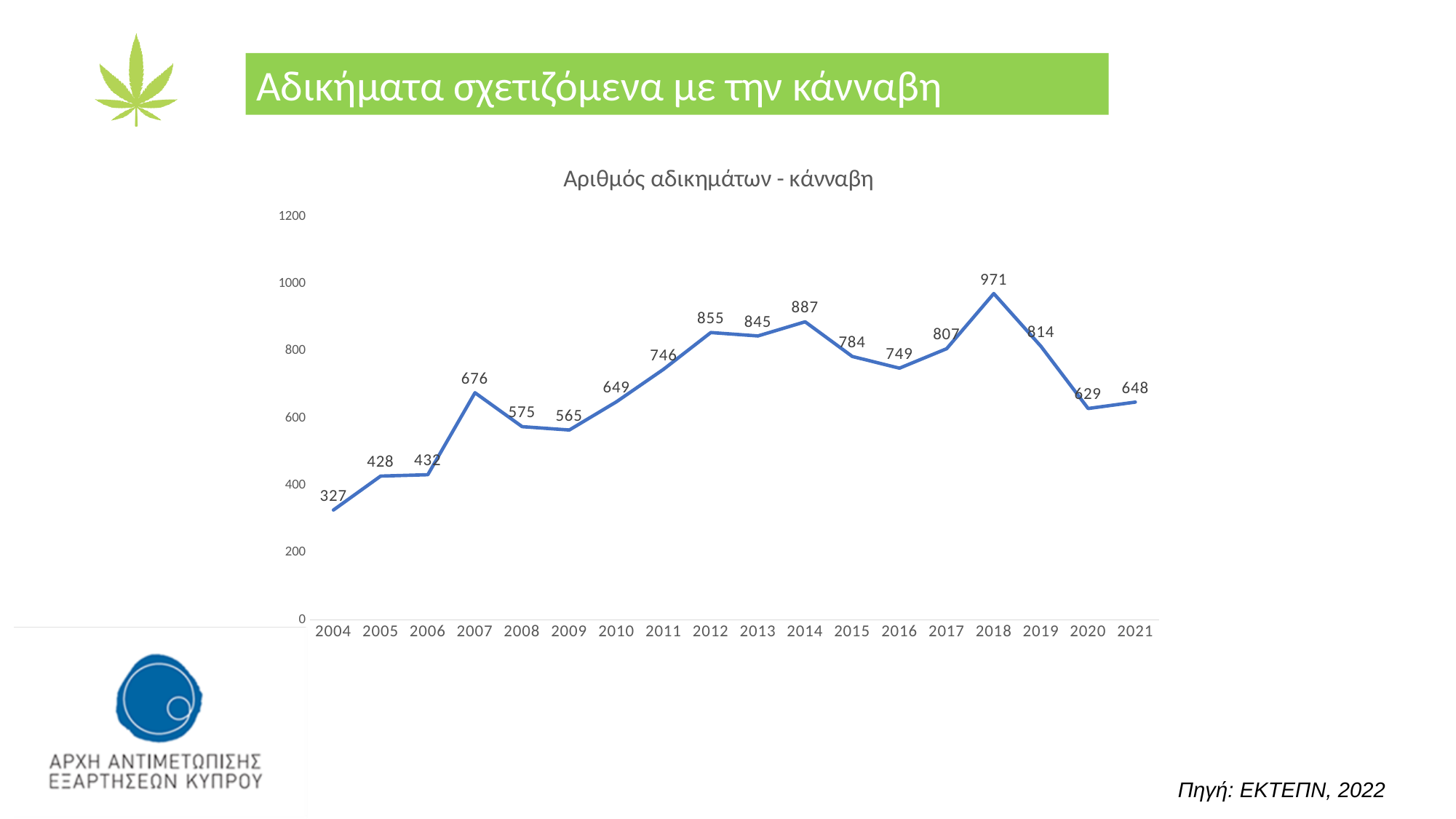
What type of chart is shown on the slide? Line chart Does the value rise or fall from 2018 to 2020? Fall What is the difference between the values for 2020 and 2021? 19 What is the number of cannabis-related offences in 2018? 971 Which year has the highest number of offences? 2018 What is the value shown for 2021? 648 How many years are plotted on the x axis? 18 What is the value shown for 2004? 327 What is the difference between the values for 2018 and 2019? 157 Which year has the lowest number of offences? 2004 What is the title of the chart? Αριθμός αδικημάτων - κάνναβη Which year has a larger value, 2012 or 2013? 2012